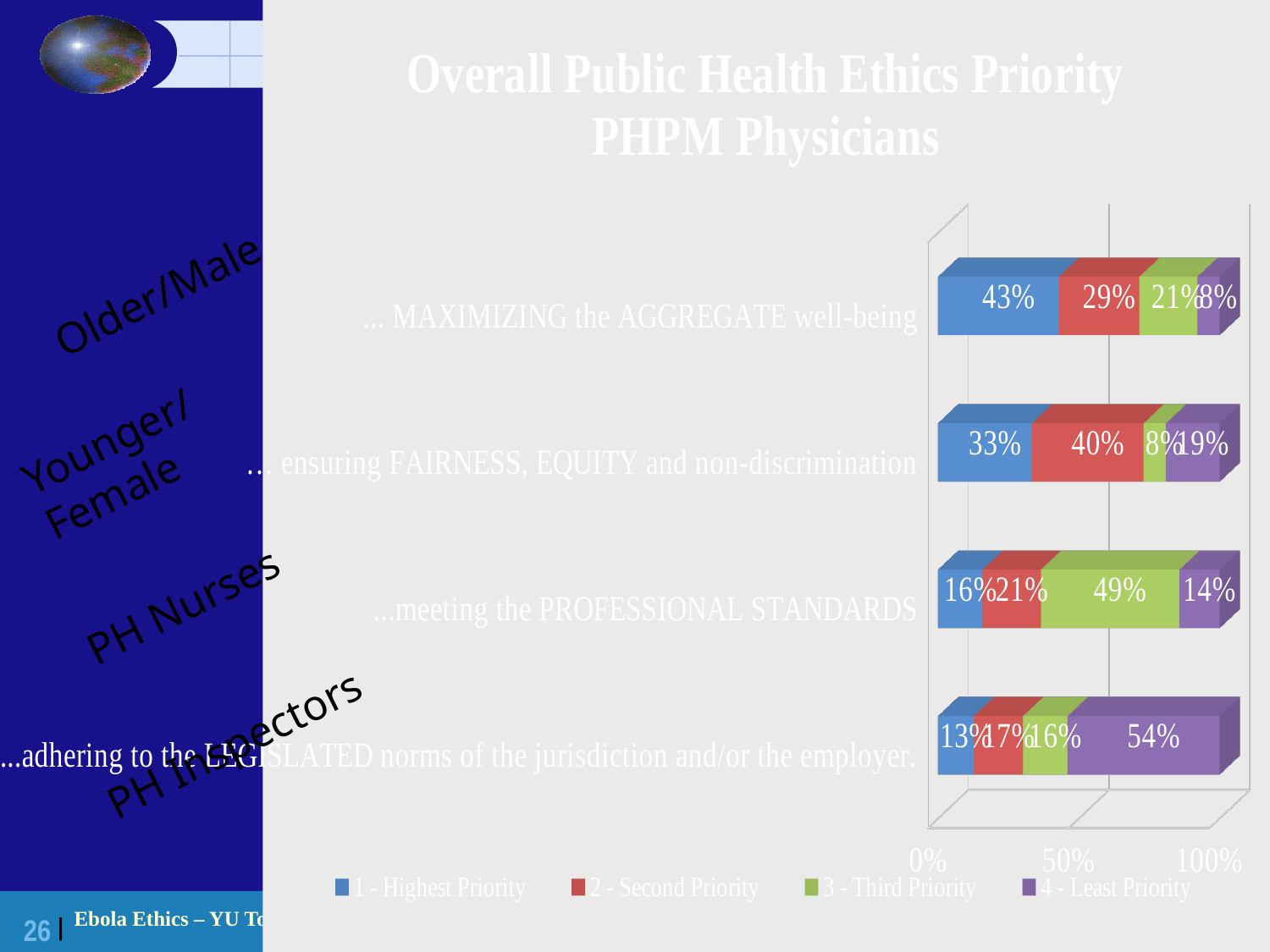
What is the '3 - Third Priority' value for '...meeting the PROFESSIONAL STANDARDS'? 49% How many categories are plotted on the chart? 4 What kind of chart is shown on the slide? Stacked bar chart Which is larger: the '2 - Second Priority' value for '... ensuring FAIRNESS, EQUITY and non-discrimination' or for '...meeting the PROFESSIONAL STANDARDS'? ... ensuring FAIRNESS, EQUITY and non-discrimination What is the '2 - Second Priority' value for '... ensuring FAIRNESS, EQUITY and non-discrimination'? 40% What is the difference between the '1 - Highest Priority' values for '... MAXIMIZING the AGGREGATE well-being' and '... ensuring FAIRNESS, EQUITY and non-discrimination'? 10% What is the '4 - Least Priority' value for '...adhering to the LEGISLATED norms of the jurisdiction and/or the employer.'? 54% What is the title of the chart? Overall Public Health Ethics Priority PHPM Physicians What is the '1 - Highest Priority' value for '... MAXIMIZING the AGGREGATE well-being'? 43% How many series does the legend list? 4 Which category has the lowest '4 - Least Priority' value? ... MAXIMIZING the AGGREGATE well-being Which category has the highest '1 - Highest Priority' value? ... MAXIMIZING the AGGREGATE well-being